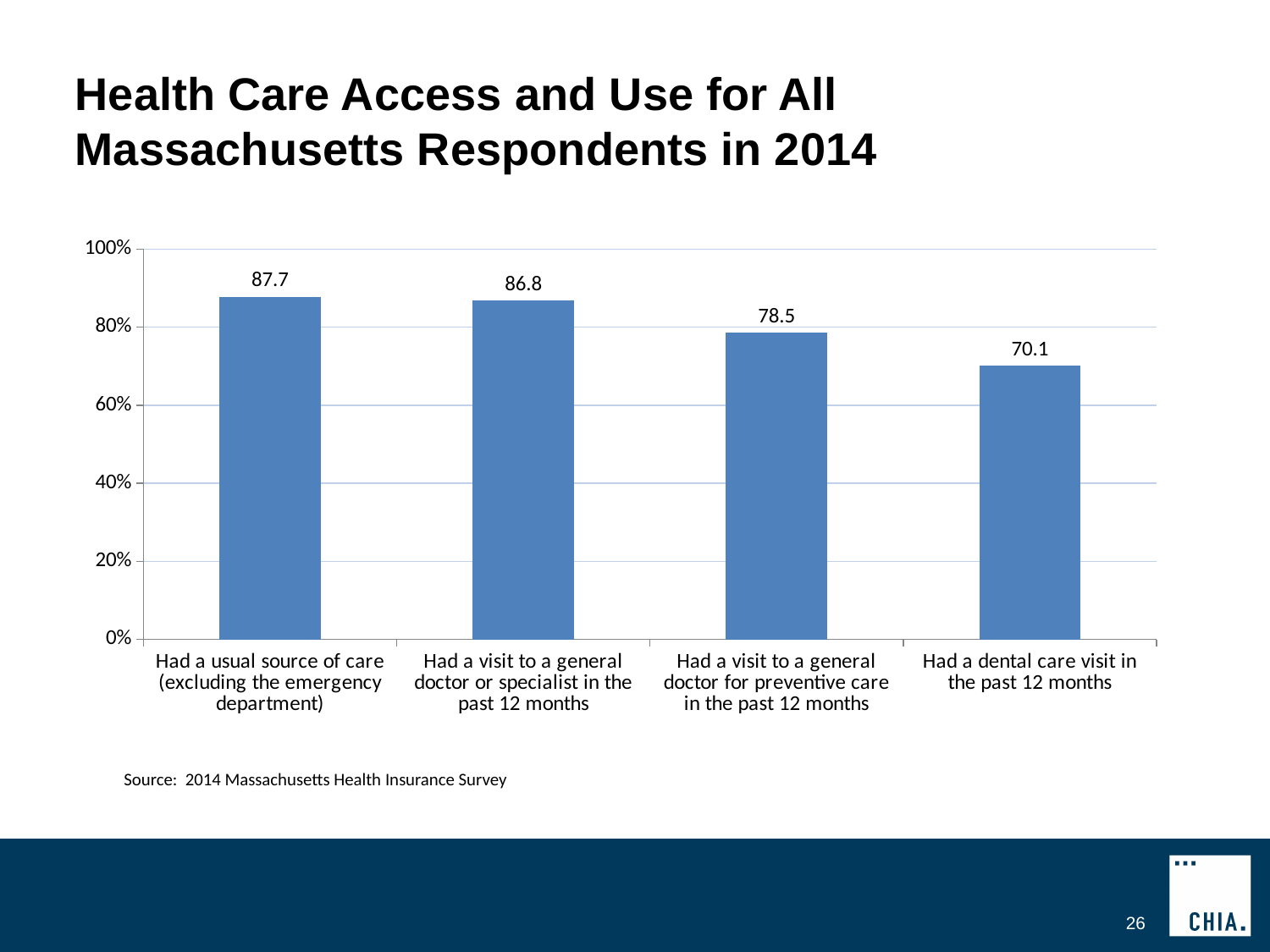
Which is larger: the value for 'Had a visit to a general doctor for preventive care in the past 12 months' or the value for 'Had a dental care visit in the past 12 months'? Had a visit to a general doctor for preventive care in the past 12 months Is the value for 'Had a dental care visit in the past 12 months' greater or less than 80%? less Which category has the lowest value? Had a dental care visit in the past 12 months What kind of chart is shown on the slide? bar chart How many categories are shown in the chart? 4 Which category has the highest value? Had a usual source of care (excluding the emergency department) What is the difference between the value for 'Had a visit to a general doctor or specialist in the past 12 months' and the value for 'Had a dental care visit in the past 12 months'? 16.7 Do the values rise or fall from left to right across the categories? fall What is the value for 'Had a dental care visit in the past 12 months'? 70.1 What is the value for 'Had a usual source of care (excluding the emergency department)'? 87.7 What is the value for 'Had a visit to a general doctor for preventive care in the past 12 months'? 78.5 What source is cited below the chart? 2014 Massachusetts Health Insurance Survey